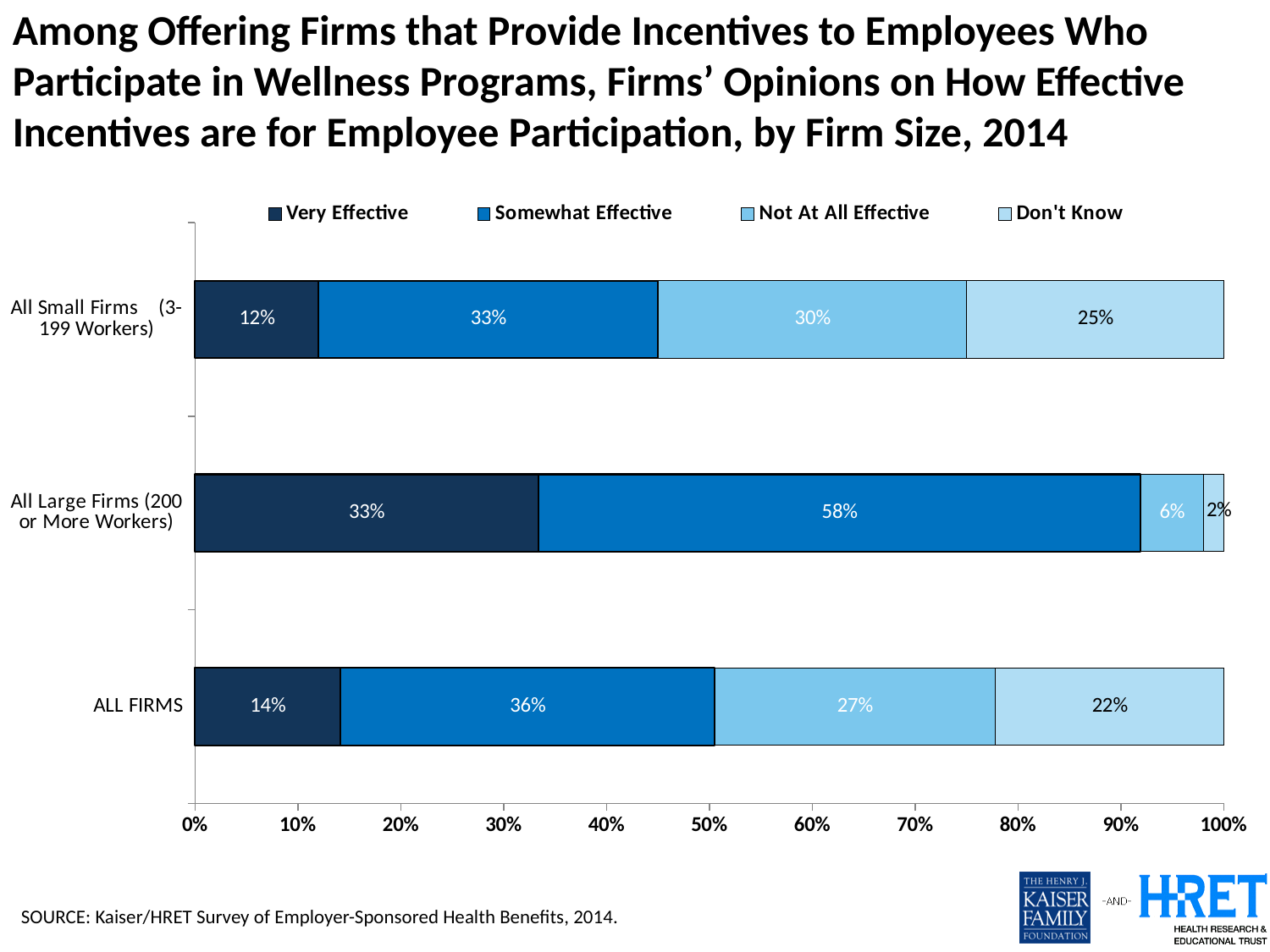
What is the combined share of all firms saying incentives are Very Effective or Somewhat Effective? 50% Which firm size category has the lowest share saying incentives are Very Effective? All Small Firms (3-199 Workers) What is the difference between the Not At All Effective share for all small firms and for all large firms? 24 percentage points What percentage of all firms answered Don't Know? 22% What kind of chart is shown on the slide? Stacked bar chart How many series does the legend list? 4 What percentage of all large firms (200 or more workers) say incentives are Not At All Effective? 6% Is the Don't Know share larger for all small firms or for all large firms? All Small Firms (3-199 Workers) Which firm size category has the highest share saying incentives are Somewhat Effective? All Large Firms (200 or More Workers) How many firm size categories are shown on the chart? 3 What percentage of all small firms (3-199 workers) say incentives are Somewhat Effective? 33% What percentage of all large firms (200 or more workers) say incentives are Very Effective? 33%